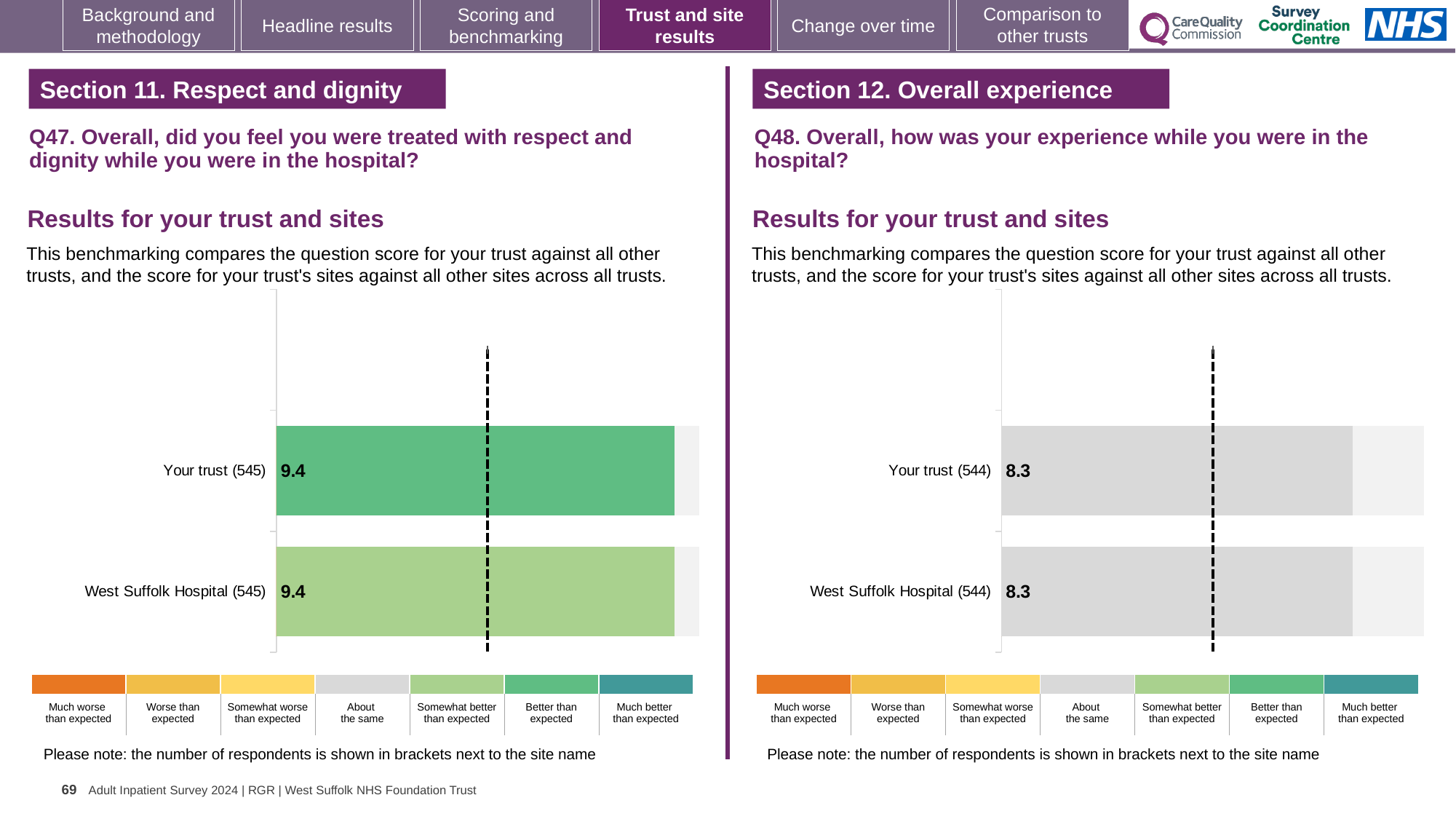
In the Q47 chart on the left, what is the score for Your trust? 9.4 In the Q48 chart on the right, what is the score for West Suffolk Hospital? 8.3 In the Q48 chart on the right, what is the difference between the score for Your trust and the score for West Suffolk Hospital? 0 In the Q47 chart on the left, how many respondents are shown in brackets next to Your trust? 545 In the Q47 chart on the left, what is the difference between the score for Your trust and the score for West Suffolk Hospital? 0 How many bars are plotted in the Q47 chart on the left? 2 What kind of chart is used for the Q47 results on the left? Bar chart In the Q48 chart on the right, what is the score for Your trust? 8.3 According to the colour key below the Q48 chart on the right, which benchmark category does the grey colour of the bars represent? About the same In the Q48 chart on the right, how many respondents are shown in brackets next to West Suffolk Hospital? 544 How many bars are plotted in the Q48 chart on the right? 2 In the Q47 chart on the left, what is the score for West Suffolk Hospital? 9.4